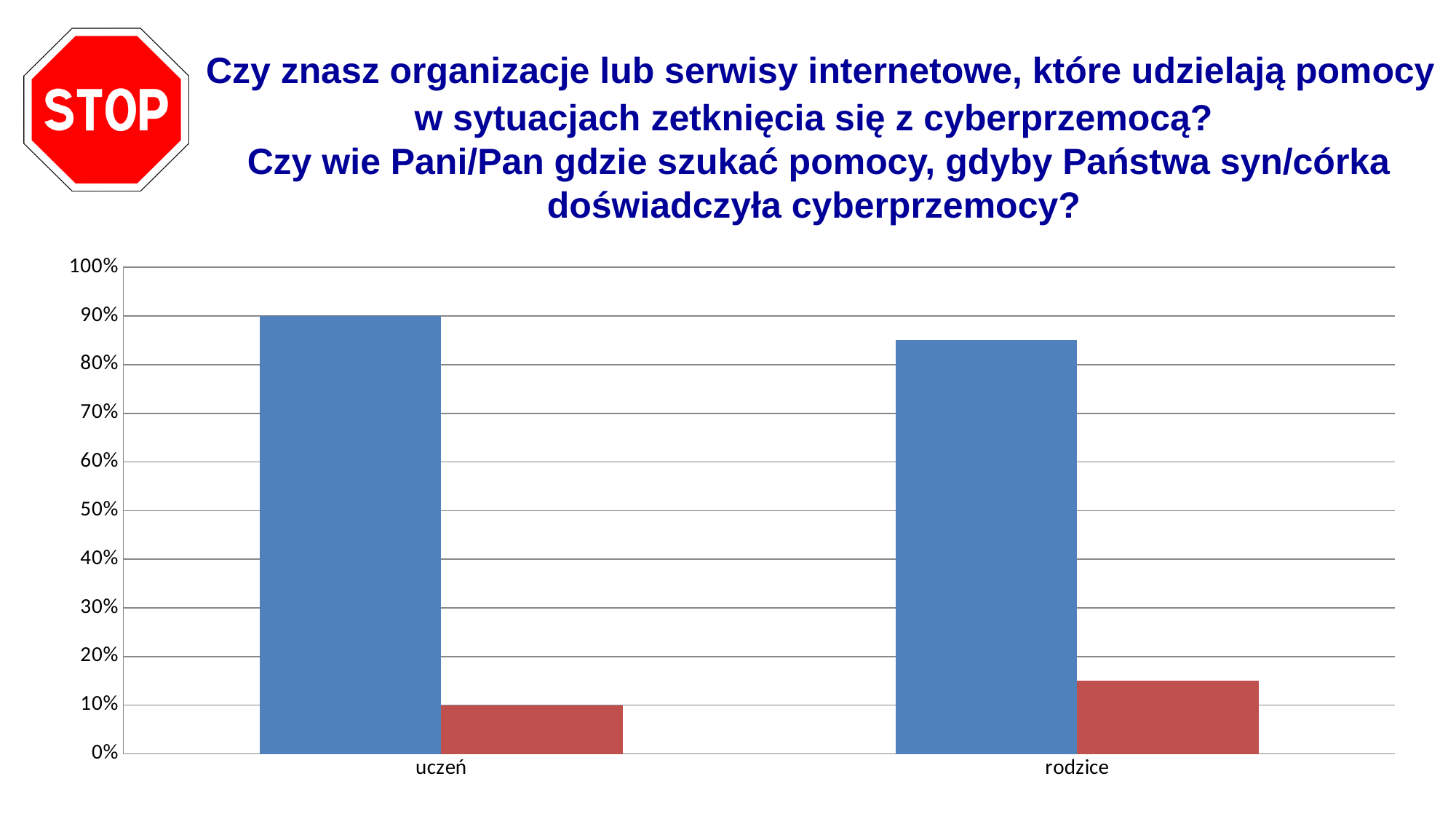
Is the value of the blue bar for rodzice greater or less than 80%? greater Is the value of the blue bar for rodzice greater or less than 90%? less What is the value of the blue bar for uczeń? 90% Is the value of the red bar for rodzice greater or less than 20%? less What is the value of the red bar for uczeń? 10% Which category has the higher blue bar, uczeń or rodzice? uczeń What is the highest value shown on the y axis of the chart? 100% How many categories are shown on the x axis of the chart? 2 What is the difference between the blue bar and the red bar for uczeń? 80% Which category has the higher red bar, uczeń or rodzice? rodzice What kind of chart is shown on the slide? bar chart